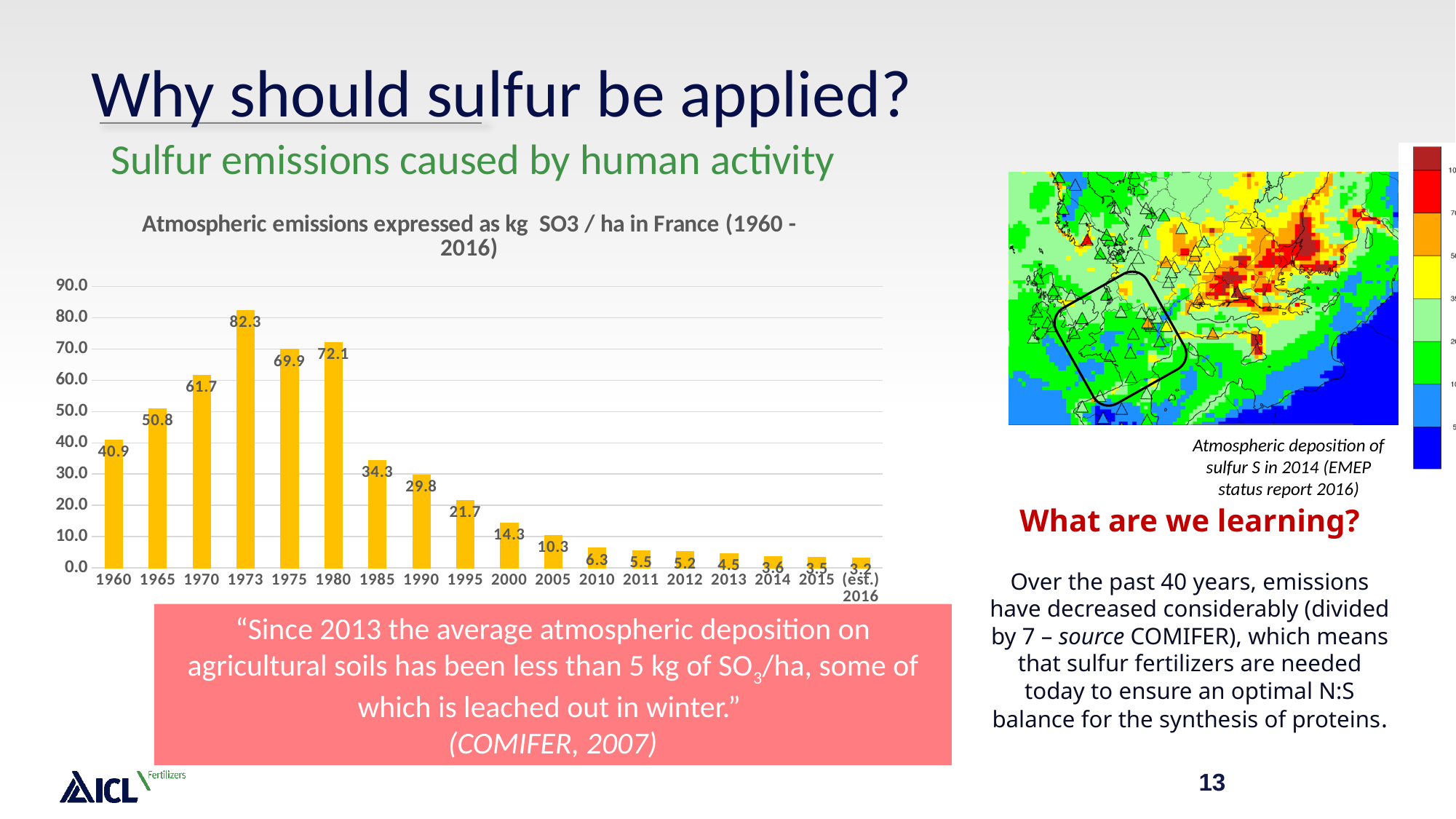
What is the title of the chart? Atmospheric emissions expressed as kg SO3 / ha in France (1960 - 2016) What is the value for 2000 in the chart? 14.3 What is the value for 1973 in the chart? 82.3 Which is larger, the value for 1985 or the value for 1990? 1985 Do the values generally rise or fall from 1980 to 2016? fall What is the difference between the values for 1980 and 1975? 2.2 Which category has the lowest value in the chart? (est.) 2016 Which year has the highest value in the chart? 1973 How many categories (years) are shown on the x axis of the chart? 18 Is the value for 1970 greater or less than 60.0? greater What kind of chart is shown on the slide? bar chart What is the value for 1960 in the chart? 40.9